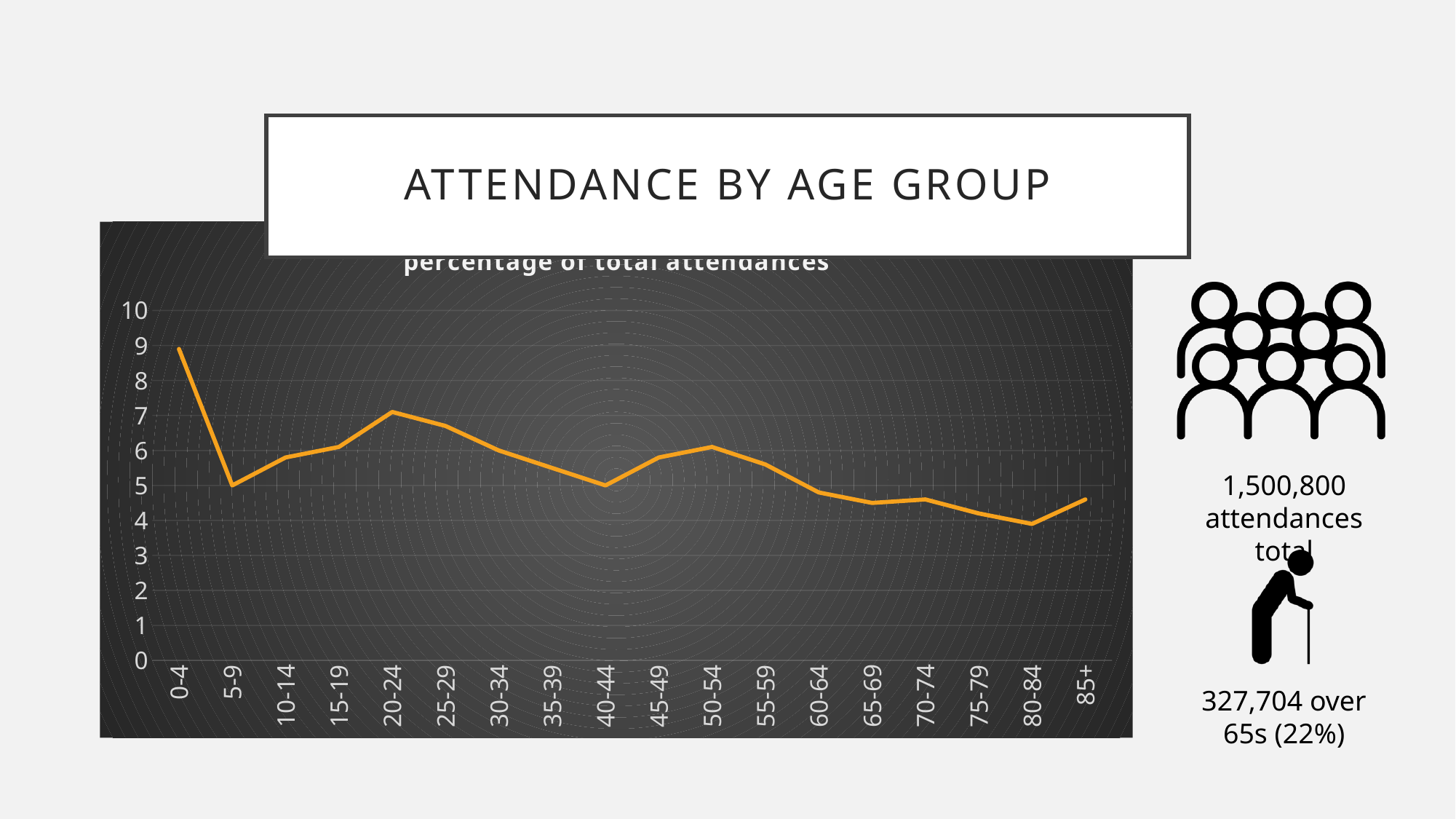
Is the value for the 80-84 age group greater or less than 5? less Which age group has a higher value, 20-24 or 40-44? 20-24 How many age groups are plotted along the x axis? 18 Does the line rise or fall between the 0-4 and 5-9 age groups? fall Is the value for the 65-69 age group greater or less than 5? less What kind of chart is shown on the slide? line chart What is the title of the slide? ATTENDANCE BY AGE GROUP Which age group has the highest percentage of total attendances? 0-4 Which age group has the lowest percentage of total attendances? 80-84 Which age group has a higher value, 0-4 or 5-9? 0-4 Is the value for the 0-4 age group greater or less than 8? greater